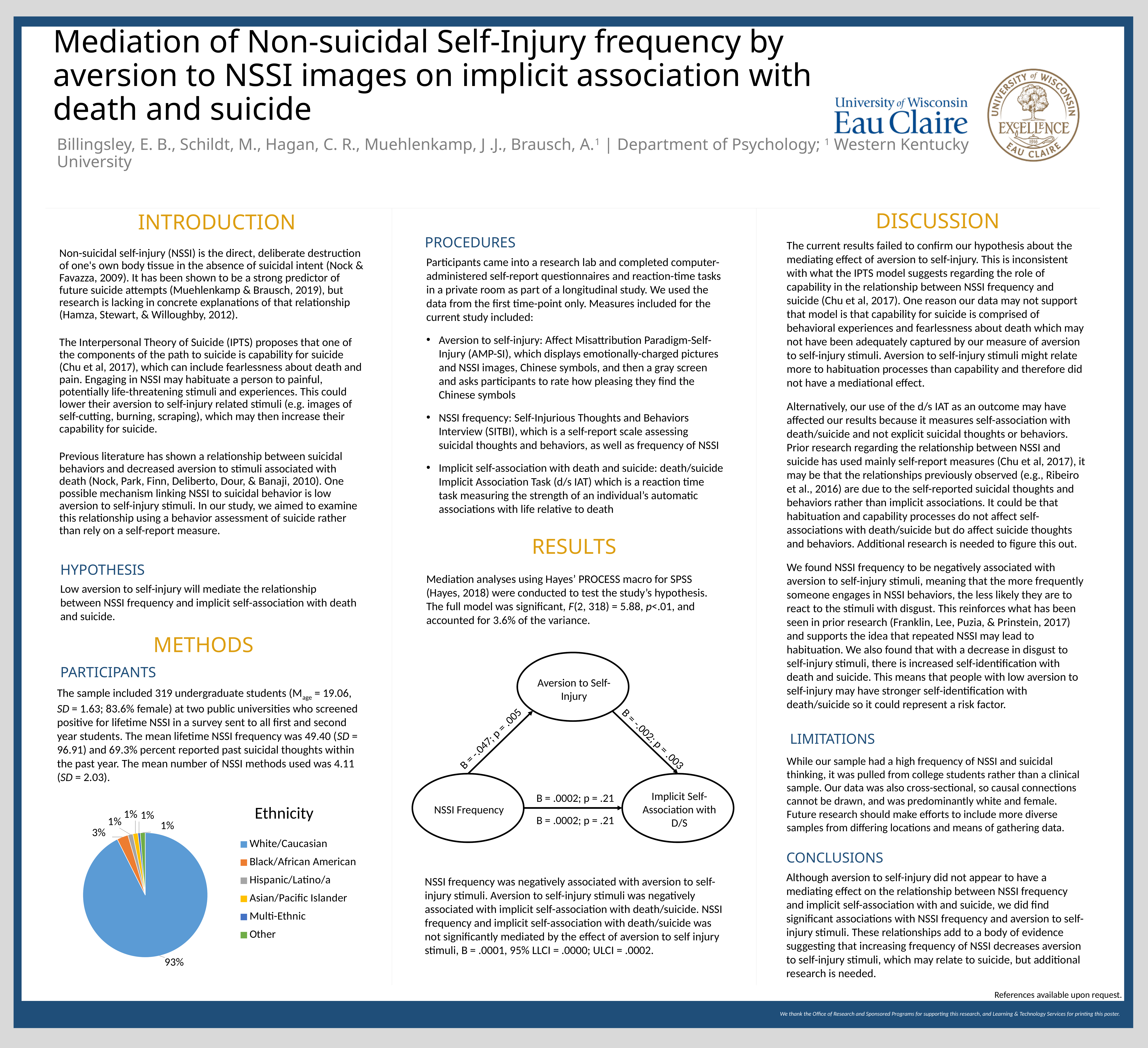
How many entries does the legend of the Ethnicity pie chart list? 6 Which category has the largest slice in the Ethnicity pie chart? White/Caucasian What colour is the White/Caucasian slice in the Ethnicity pie chart? blue In the Ethnicity pie chart, what is the difference in percentage points between White/Caucasian and Black/African American? 90 What kind of chart is the Ethnicity chart? pie chart How many categories does the Ethnicity pie chart show? 6 In the Ethnicity pie chart, what percentage is shown for Other? 1% In the Ethnicity pie chart, what percentage is shown for Black/African American? 3% In the Ethnicity pie chart, what percentage is shown for Hispanic/Latino/a? 1% In the Ethnicity pie chart, which is larger: White/Caucasian or Black/African American? White/Caucasian What is the title of the pie chart on the slide? Ethnicity In the Ethnicity pie chart, what percentage is shown for White/Caucasian? 93%